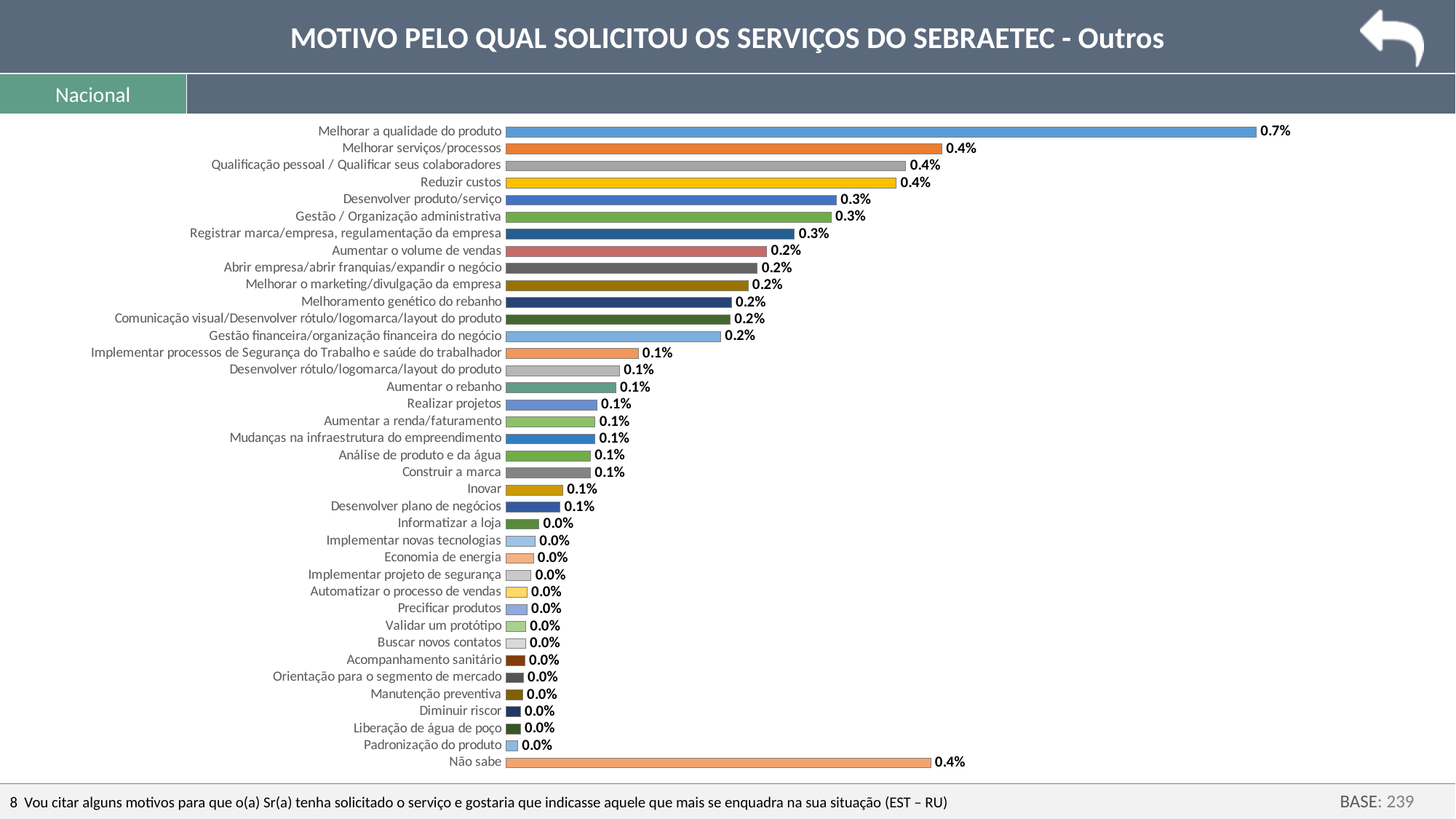
What is the value for "Gestão / Organização administrativa"? 0.3% Which category has the highest value? Melhorar a qualidade do produto What kind of chart is shown on the slide? Bar chart What is the value for "Reduzir custos"? 0.4% What is the value for "Inovar"? 0.1% Which is larger, the value for "Desenvolver produto/serviço" or the value for "Aumentar o volume de vendas"? Desenvolver produto/serviço What is the title of the slide? MOTIVO PELO QUAL SOLICITOU OS SERVIÇOS DO SEBRAETEC - Outros What is the difference between the values for "Melhorar a qualidade do produto" and "Melhorar serviços/processos"? 0.3% What is the value for "Gestão financeira/organização financeira do negócio"? 0.2% How many categories are shown in the chart? 38 What is the value for "Não sabe"? 0.4% What is the value for "Melhorar a qualidade do produto"? 0.7%